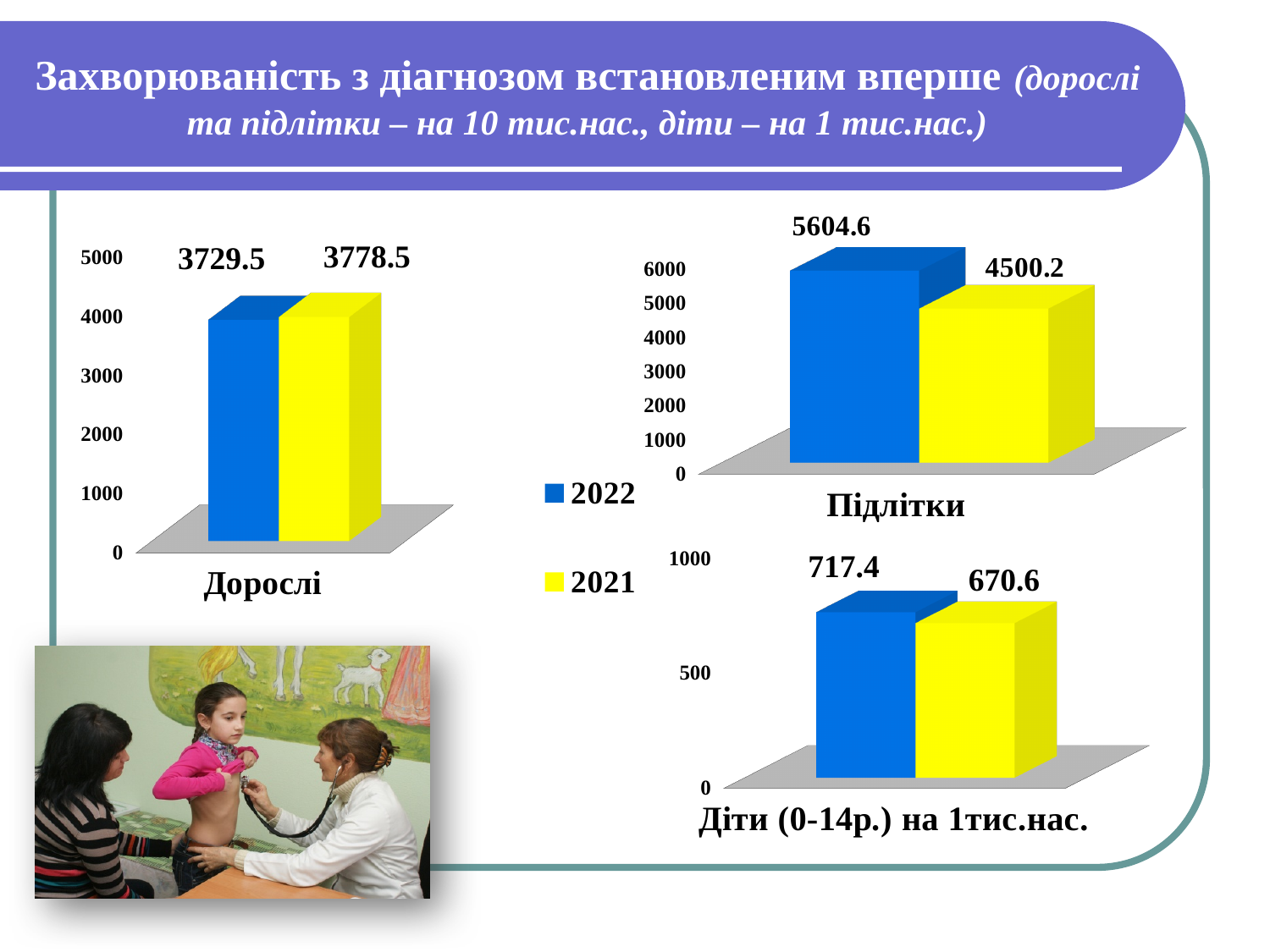
In the "Дорослі" chart, what is the value for 2021? 3778.5 In the "Підлітки" chart, which year has the larger value, 2022 or 2021? 2022 What kind of chart is the "Дорослі" chart? bar chart In the "Діти (0-14р.) на 1тис.нас." chart, what is the difference between the 2022 and 2021 values? 46.8 In the "Діти (0-14р.) на 1тис.нас." chart, what is the value for 2022? 717.4 In the "Підлітки" chart, what is the value for 2021? 4500.2 In the "Підлітки" chart, is the value for 2021 greater or less than 5000? less In the "Підлітки" chart, what is the difference between the 2022 and 2021 values? 1104.4 In the "Підлітки" chart, what is the value for 2022? 5604.6 How many series does the legend list? 2 In the "Дорослі" chart, what is the value for 2022? 3729.5 In the "Діти (0-14р.) на 1тис.нас." chart, what is the value for 2021? 670.6